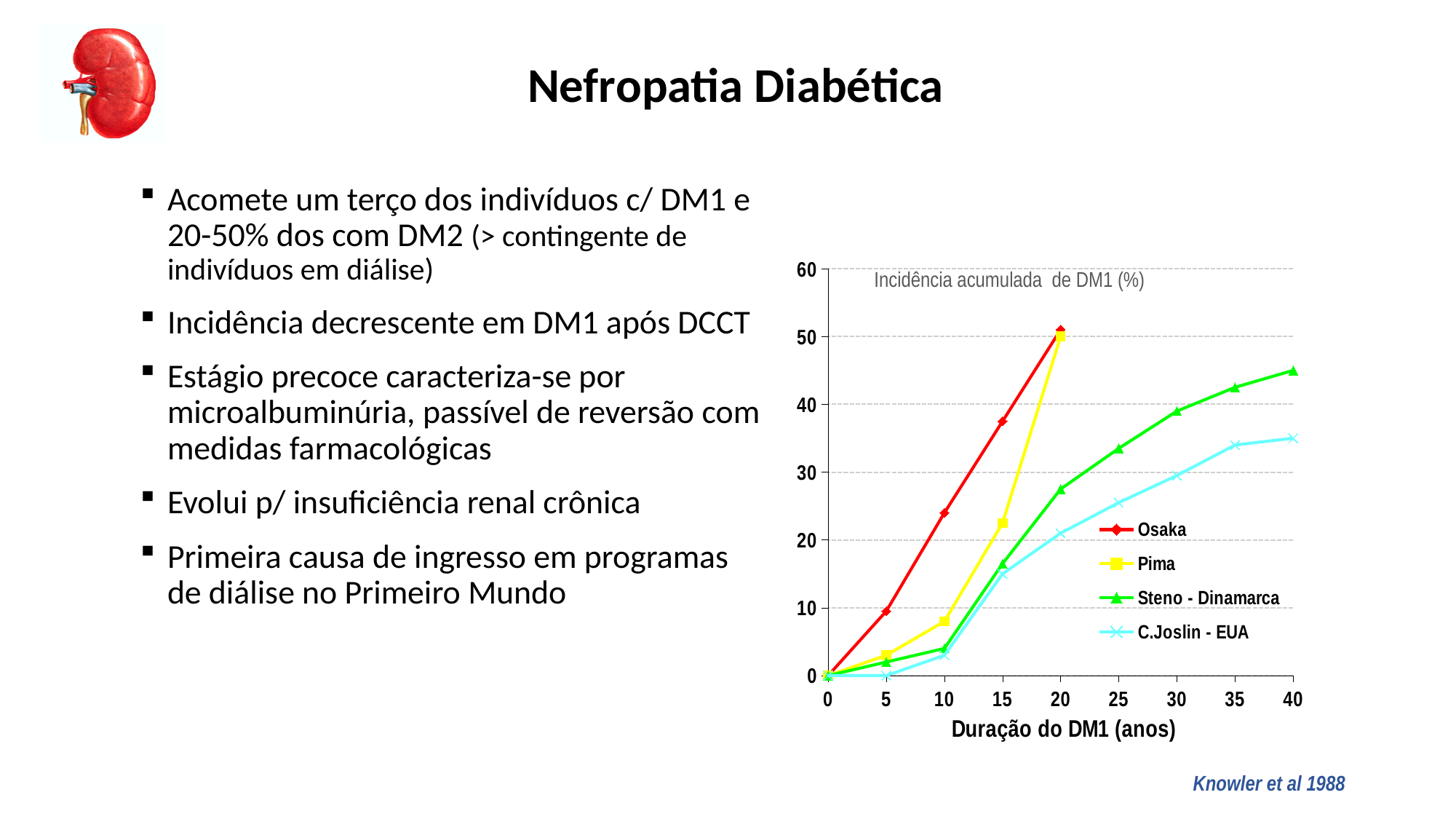
Is the value for C.Joslin - EUA at 40 years greater or less than 40? less How many series does the chart legend list? 4 At 40 years, which series has the larger value, Steno - Dinamarca or C.Joslin - EUA? Steno - Dinamarca What kind of chart is shown on the slide? line chart At 15 years, which series has the larger value, Osaka or Pima? Osaka Do the values for Steno - Dinamarca rise or fall as the duration of DM1 increases? rise What is the title of the x axis of the chart? Duração do DM1 (anos) Is the value for Pima at 10 years greater or less than 10? less Is the value for Osaka at 15 years greater or less than 30? greater Which series is drawn in red? Osaka